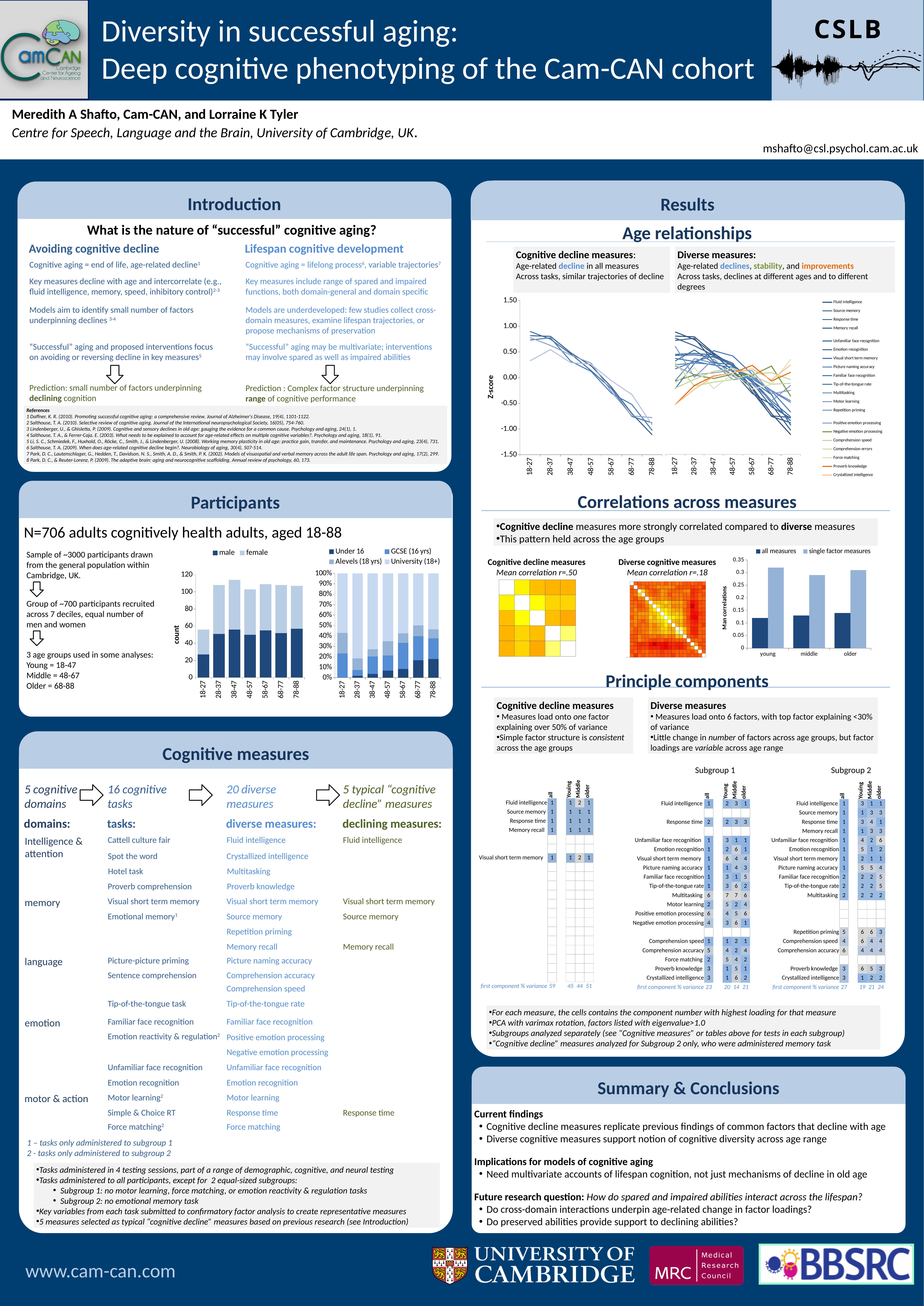
What kind of chart is the male/female chart in the Participants section? bar chart In the Correlations across measures bar chart, is the all measures value for the young group greater or less than 0.15? less In the male/female Participants chart, is the total count for the 38-47 age group greater or less than 100? greater How many series does the legend of the male/female Participants chart list? 2 In the Correlations across measures bar chart, which is larger for the young group: all measures or single factor measures? single factor measures In the male/female Participants chart, which age group has the lowest total count? 18-27 In the left panel of the Age relationships chart (cognitive decline measures), do the Z-scores rise or fall from 18-27 to 78-88? fall What kind of chart is the Age relationships chart in the Results section? line chart In the male/female Participants chart, is the male count for the 18-27 age group greater or less than 40? less How many series does the legend of the education (Under 16 / GCSE / Alevels / University) Participants chart list? 4 How many age groups are shown on the x axis of the male/female Participants chart? 7